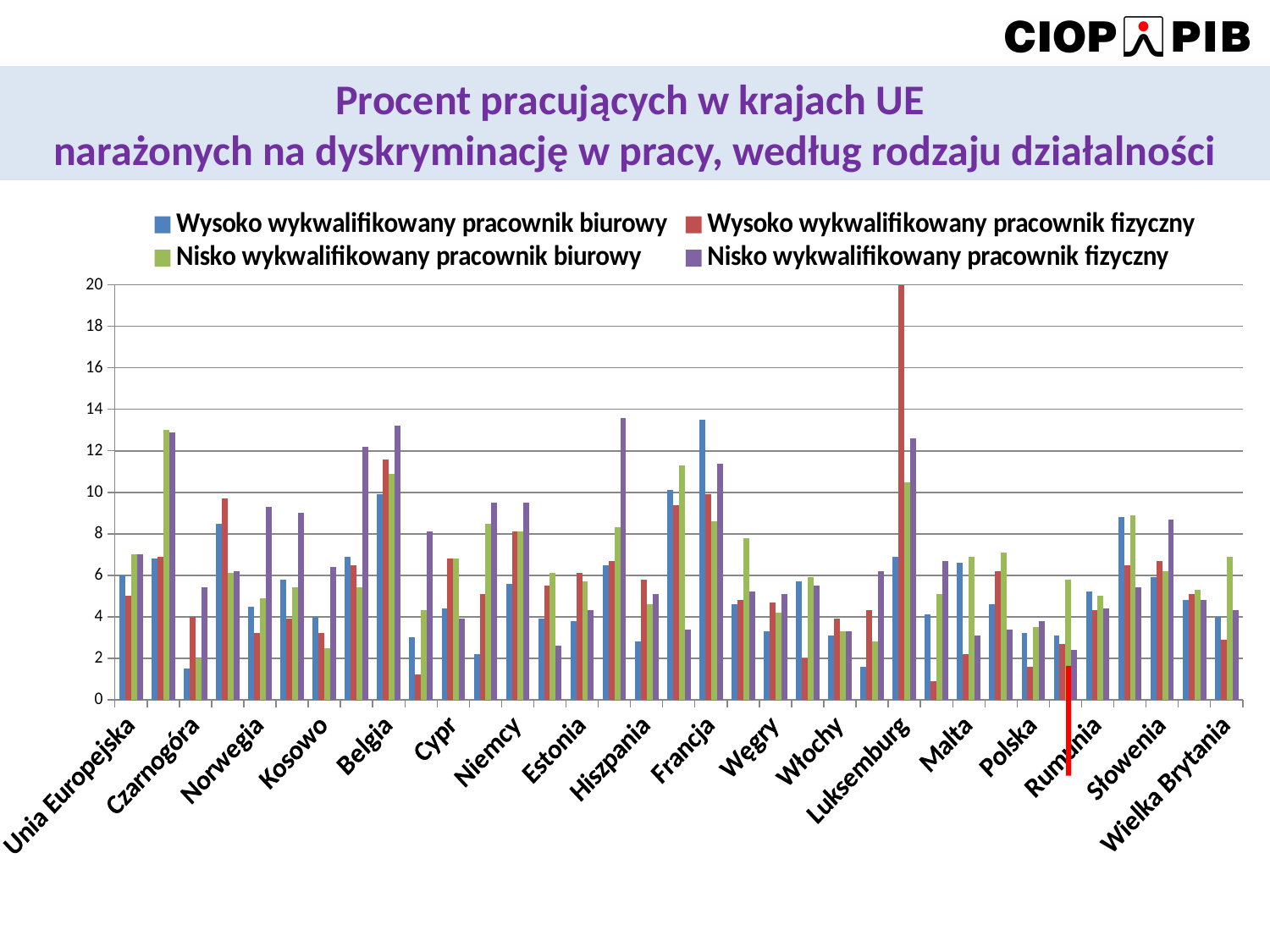
Is the value for 'Wysoko wykwalifikowany pracownik biurowy' in Czarnogóra greater or less than 4? less Is the value for 'Nisko wykwalifikowany pracownik fizyczny' in Hiszpania greater or less than 12? less Which is larger: the value for 'Wysoko wykwalifikowany pracownik biurowy' in Francja or in Belgia? Francja What kind of chart is shown on the slide? bar chart What is the highest value shown on the vertical axis? 20 Is the value for 'Wysoko wykwalifikowany pracownik fizyczny' in Luksemburg greater or less than 14? greater In Luksemburg, which is larger: the value for 'Wysoko wykwalifikowany pracownik biurowy' or for 'Wysoko wykwalifikowany pracownik fizyczny'? Wysoko wykwalifikowany pracownik fizyczny How many series does the legend list? 4 Which country has the highest value for the series 'Wysoko wykwalifikowany pracownik fizyczny'? Luksemburg